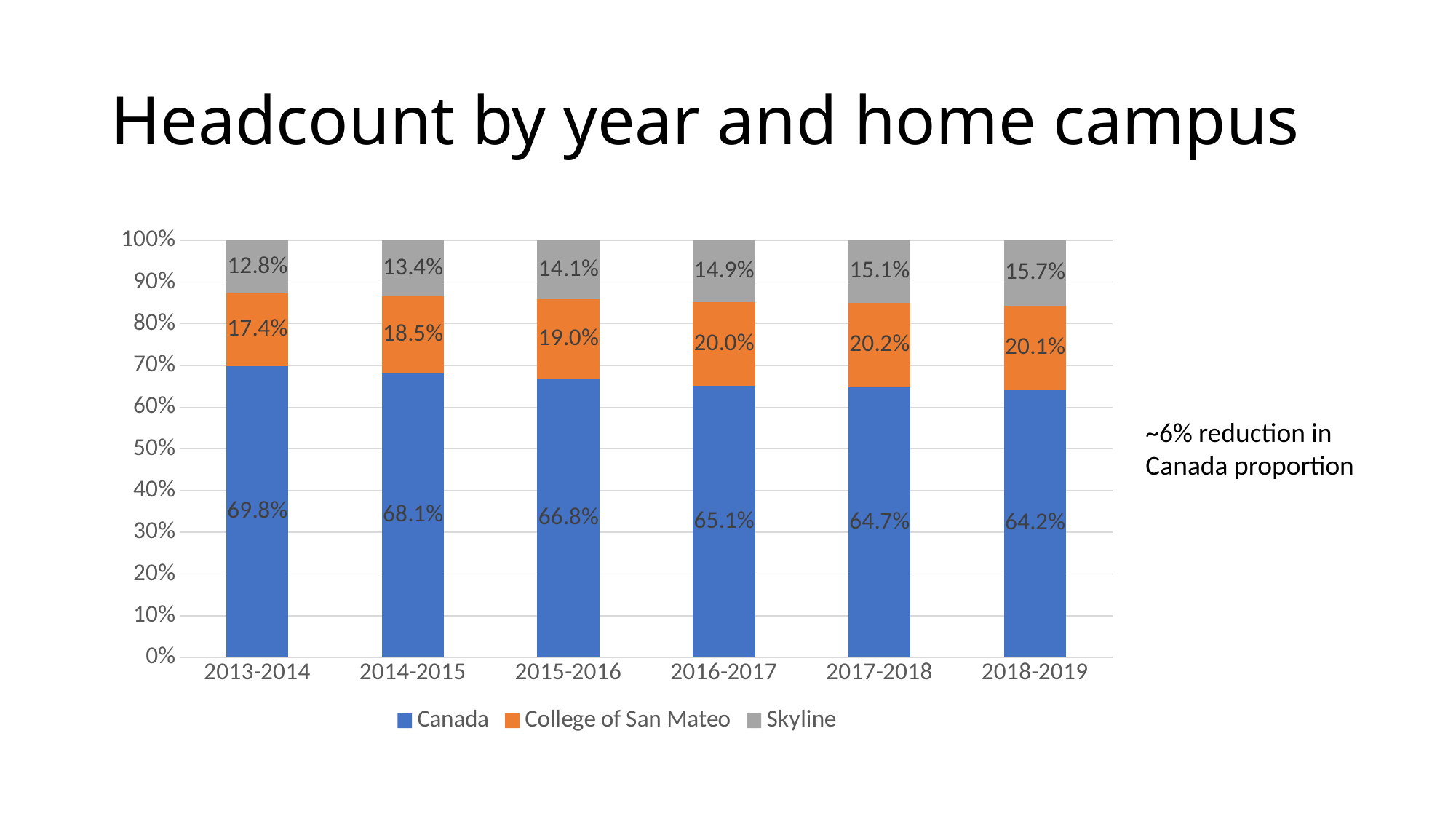
Does the Canada share of headcount rise or fall from 2013-2014 to 2018-2019? Fall Which is larger in 2015-2016: the College of San Mateo share or the Skyline share? College of San Mateo In which year is the Canada share of headcount lowest? 2018-2019 What is the Canada share of headcount in 2013-2014? 69.8% How many years are shown on the x axis? 6 What is the title of the chart? Headcount by year and home campus How many series does the legend list? 3 What kind of chart is shown on the slide? Stacked bar chart What is the difference between the Canada share in 2013-2014 and in 2018-2019? 5.6% In which year is the Skyline share of headcount highest? 2018-2019 What is the Skyline share of headcount in 2018-2019? 15.7% What is the College of San Mateo share of headcount in 2016-2017? 20.0%